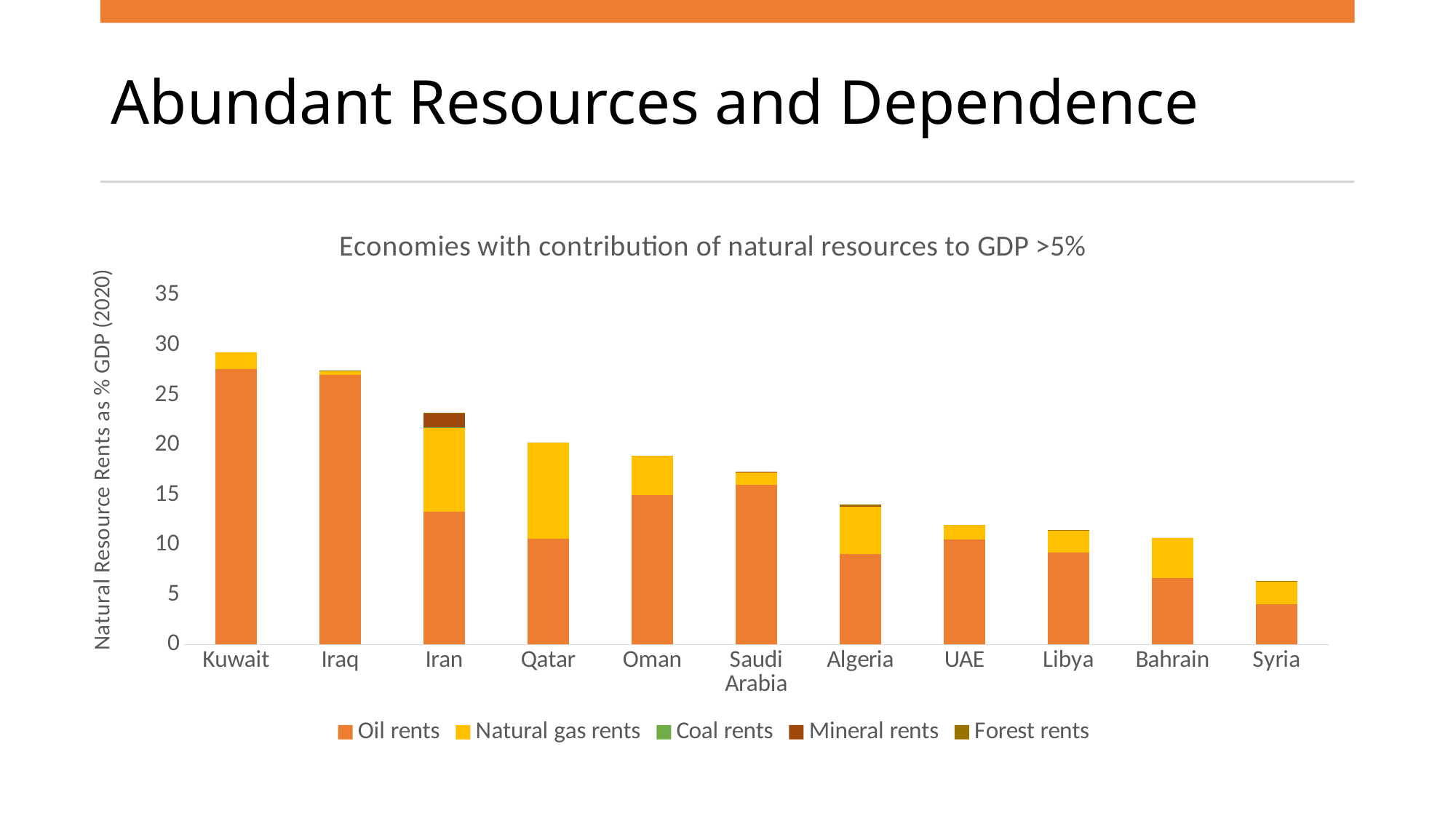
Is the total value for Syria greater or less than 10? less Which economy has the highest total natural resource rents as % of GDP? Kuwait Is the Oil rents value for Iran greater or less than 15? less What kind of chart is shown on the slide? Stacked bar chart Which has a larger total bar, Qatar or Oman? Qatar How many economies are shown on the x axis of the chart? 11 Which economy has the lowest total natural resource rents as % of GDP? Syria What is the title of the chart? Economies with contribution of natural resources to GDP >5% Is the total value for Kuwait greater or less than 25? greater How many series does the chart's legend list? 5 What is the label on the vertical axis of the chart? Natural Resource Rents as % GDP (2020) Do the total bar heights rise or fall moving from left to right along the x axis? Fall